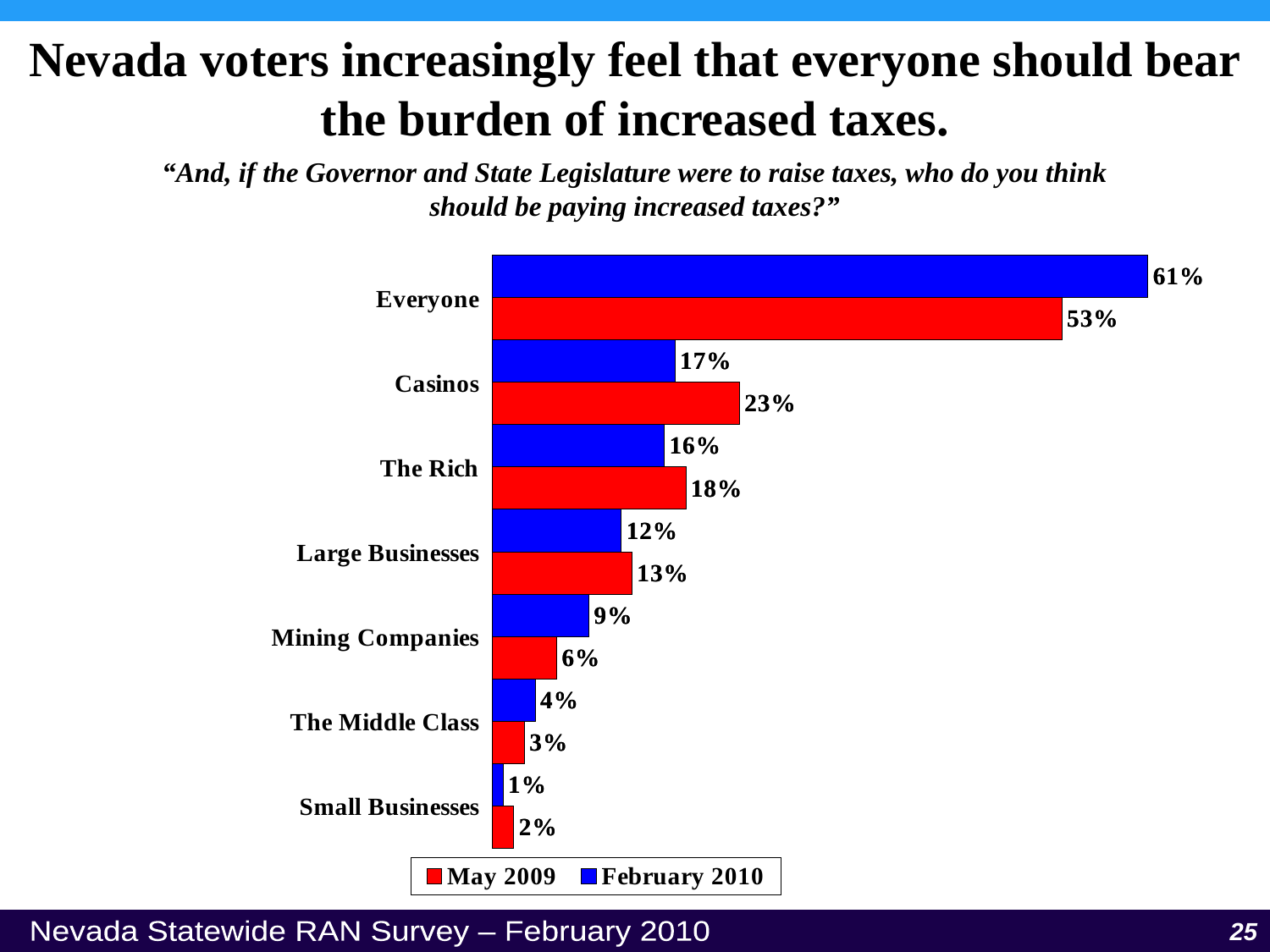
How many series does the legend list? 2 For Mining Companies, which survey had the larger value, May 2009 or February 2010? February 2010 Which category has the highest value in February 2010? Everyone For The Rich, which survey had the larger value, May 2009 or February 2010? May 2009 What was the May 2009 value for Casinos? 23% How many categories are shown on the chart? 7 Which category has the lowest value in February 2010? Small Businesses What is the difference between the May 2009 and February 2010 values for Casinos? 6 percentage points What percentage of voters said Everyone should pay increased taxes in February 2010? 61% What was the February 2010 value for Mining Companies? 9% By how many percentage points did the value for Everyone change from May 2009 to February 2010? 8 percentage points What kind of chart is shown on the slide? Bar chart